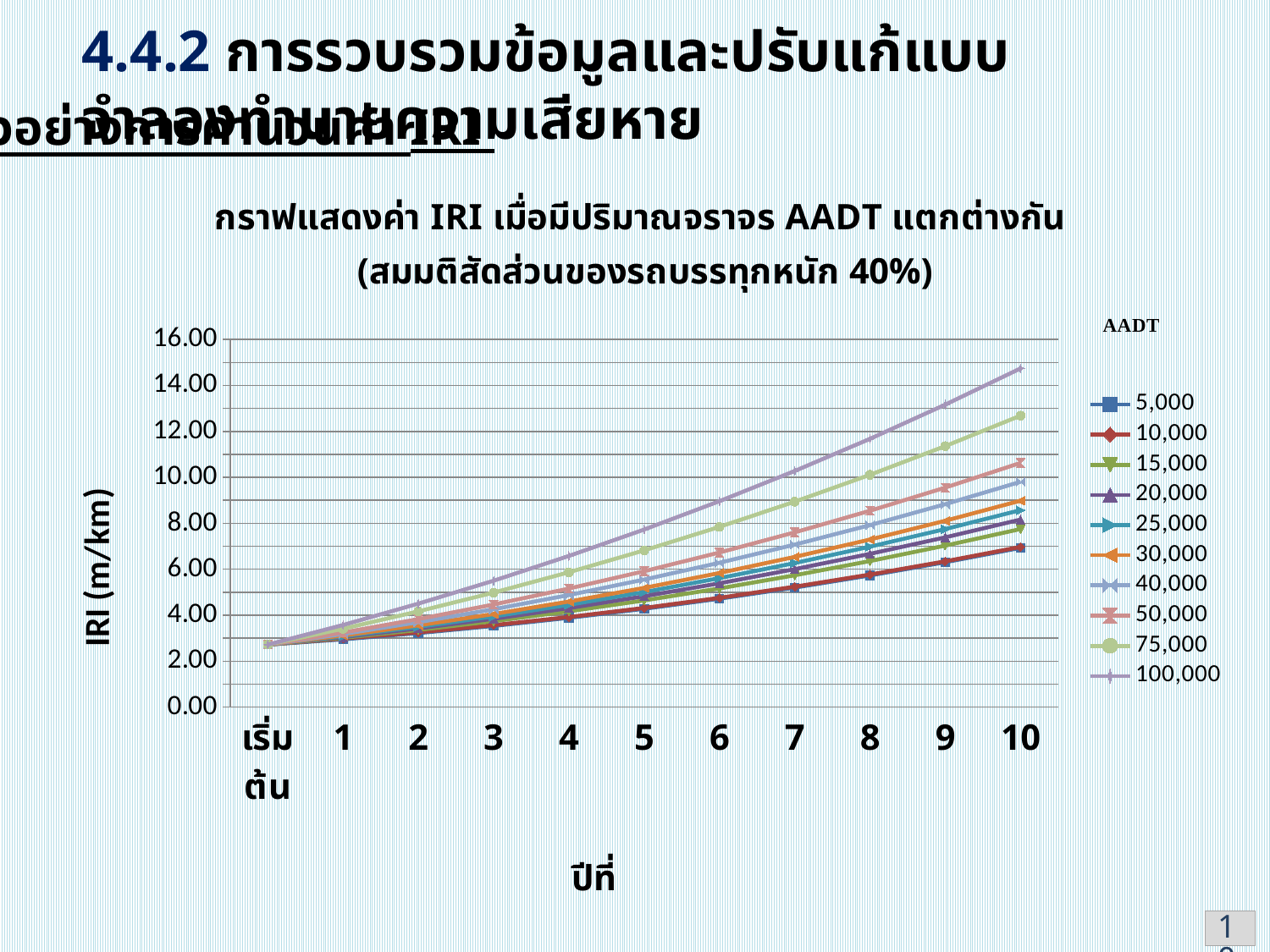
What is the title of the legend? AADT At year 10, which is larger: the IRI for AADT 100,000 or for AADT 5,000? 100,000 Which AADT series has the highest IRI value at year 10? 100,000 Is the IRI value for AADT 100,000 at year 10 greater or less than 14.00? greater Is the IRI value for AADT 75,000 at year 10 greater or less than 12.00? greater Do the IRI values rise or fall as the year increases? rise Is the IRI value for AADT 5,000 at year 10 greater or less than 8.00? less What kind of chart is shown on the slide? line chart How many series does the legend list? 10 What is the label of the y axis? IRI (m/km) How many points are there along the x axis (including the starting point)? 11